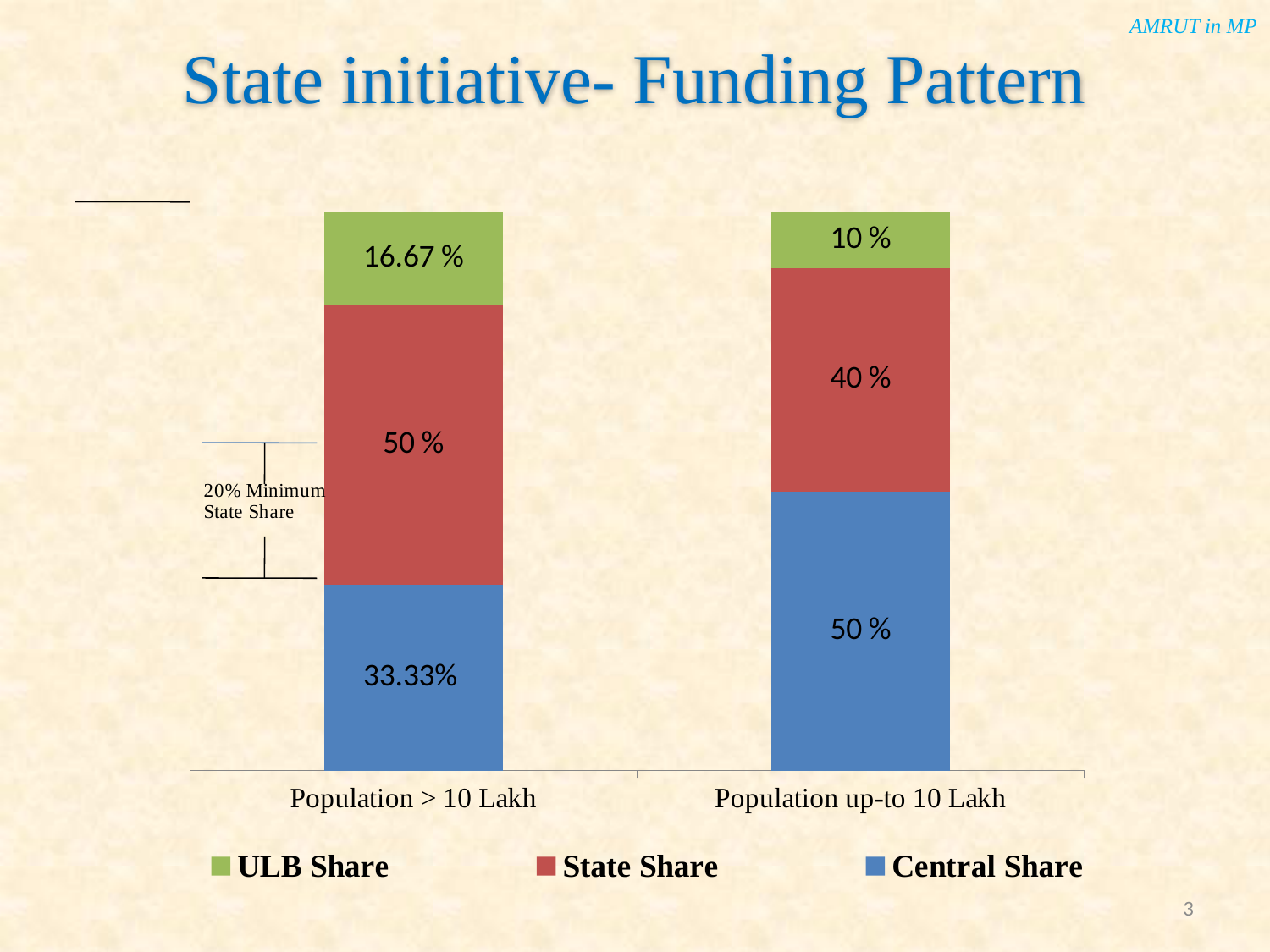
How many series does the legend list? 3 What is the State Share for Population up-to 10 Lakh? 40 % What kind of chart is shown on the slide? Stacked bar chart What is the ULB Share for Population up-to 10 Lakh? 10 % Which is larger: the Central Share for Population > 10 Lakh or for Population up-to 10 Lakh? Population up-to 10 Lakh Which series has the largest share in the Population > 10 Lakh bar? State Share What is the total of the Population up-to 10 Lakh stacked bar? 100% Which series has the smallest share in the Population up-to 10 Lakh bar? ULB Share What is the difference between the State Share for Population > 10 Lakh and for Population up-to 10 Lakh? 10 percentage points What is the Central Share for Population > 10 Lakh? 33.33% How many categories are shown on the x axis? 2 What is the State Share for Population > 10 Lakh? 50 %